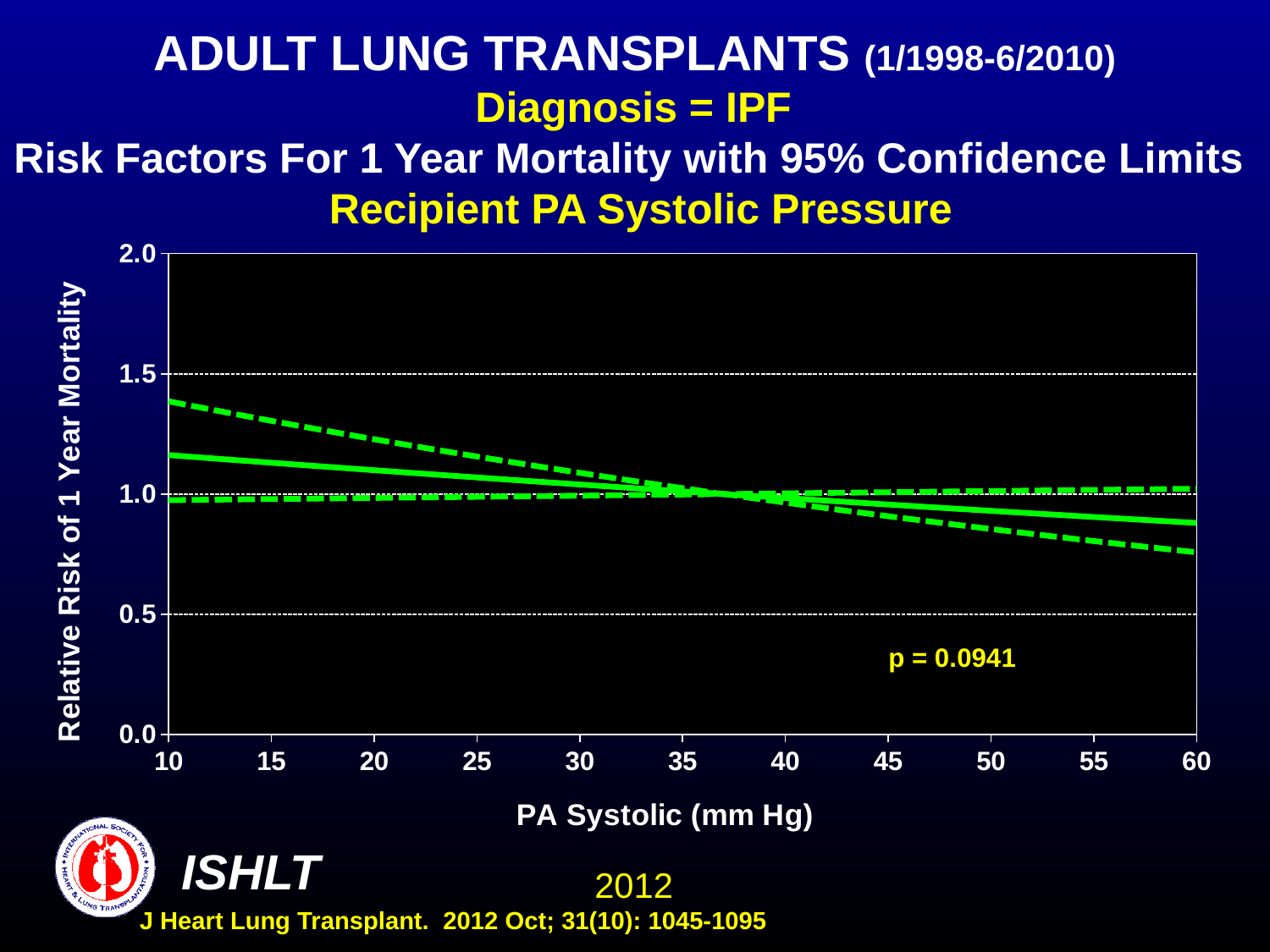
Does the solid line for relative risk of 1 year mortality rise or fall as PA systolic pressure increases from 10 to 60 mm Hg? fall Is the lower 95% confidence limit (lower dashed line) at a PA systolic pressure of 10 mm Hg greater or less than 0.5? greater What is the label of the x axis of the chart? PA Systolic (mm Hg) Is the relative risk shown by the solid line at a PA systolic pressure of 60 mm Hg greater or less than 1.0? less What p-value is printed on the chart? p = 0.0941 What kind of chart is shown on the slide? line chart Is the upper 95% confidence limit (upper dashed line) at a PA systolic pressure of 10 mm Hg greater or less than 1.5? less How many lines are plotted on the chart? 3